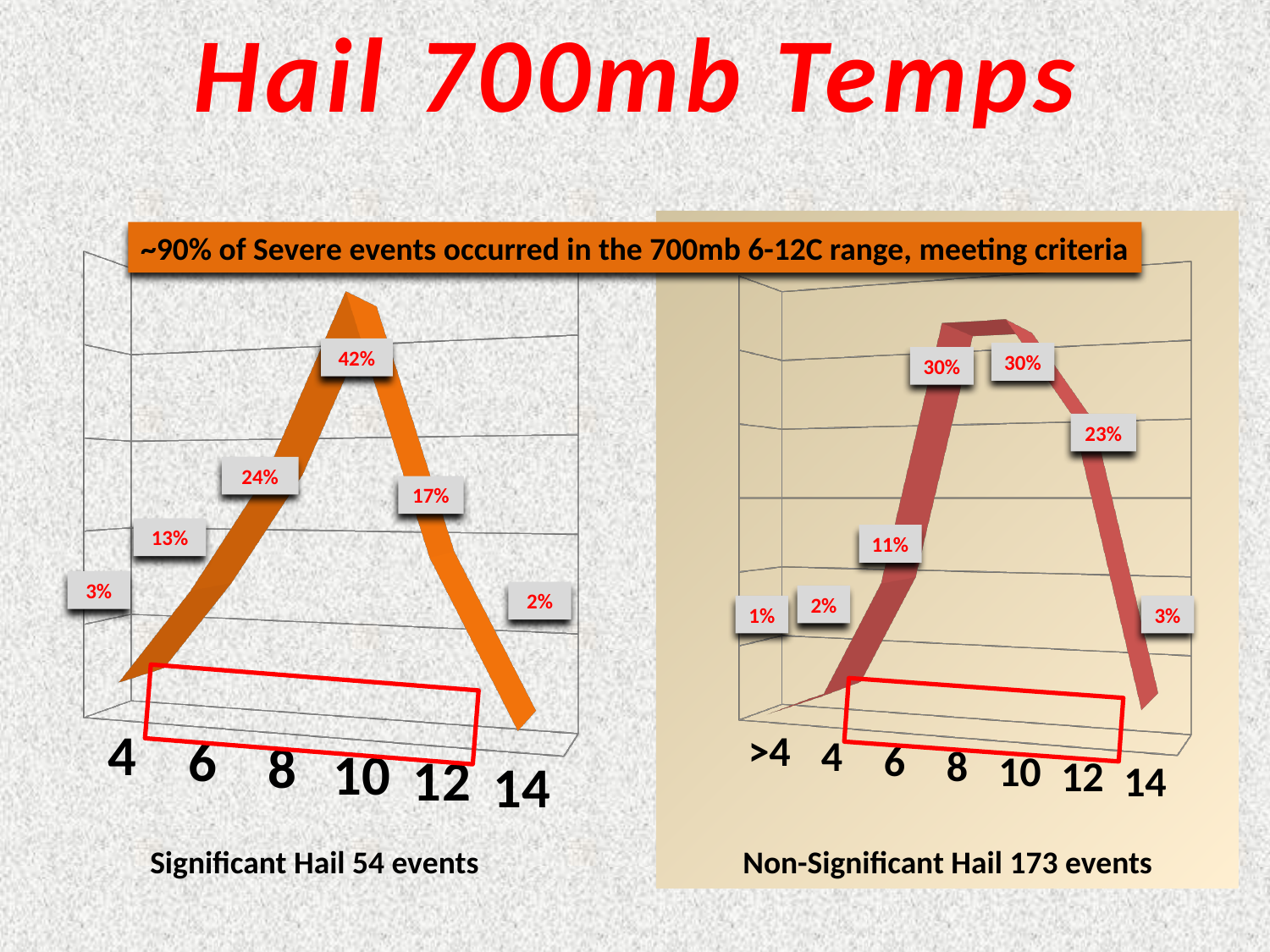
In the Non-Significant Hail 173 events chart, which category has the lowest value? >4 In the Significant Hail 54 events chart, what is the value for 6? 13% In the Significant Hail 54 events chart, what is the difference between the values for 8 and 10? 18% In the Non-Significant Hail 173 events chart, what is the value for 12? 23% What is the title of the slide? Hail 700mb Temps In the Non-Significant Hail 173 events chart, what is the value for 6? 11% In the Non-Significant Hail 173 events chart, which is larger, the value for 6 or the value for 12? 12 In the Significant Hail 54 events chart, which category has the lowest value? 14 In the Non-Significant Hail 173 events chart, how many categories are shown on the x axis? 7 In the Significant Hail 54 events chart, how many categories are shown on the x axis? 6 In the Significant Hail 54 events chart, what is the value for 8? 24% In the Significant Hail 54 events chart, which category has the highest value? 10